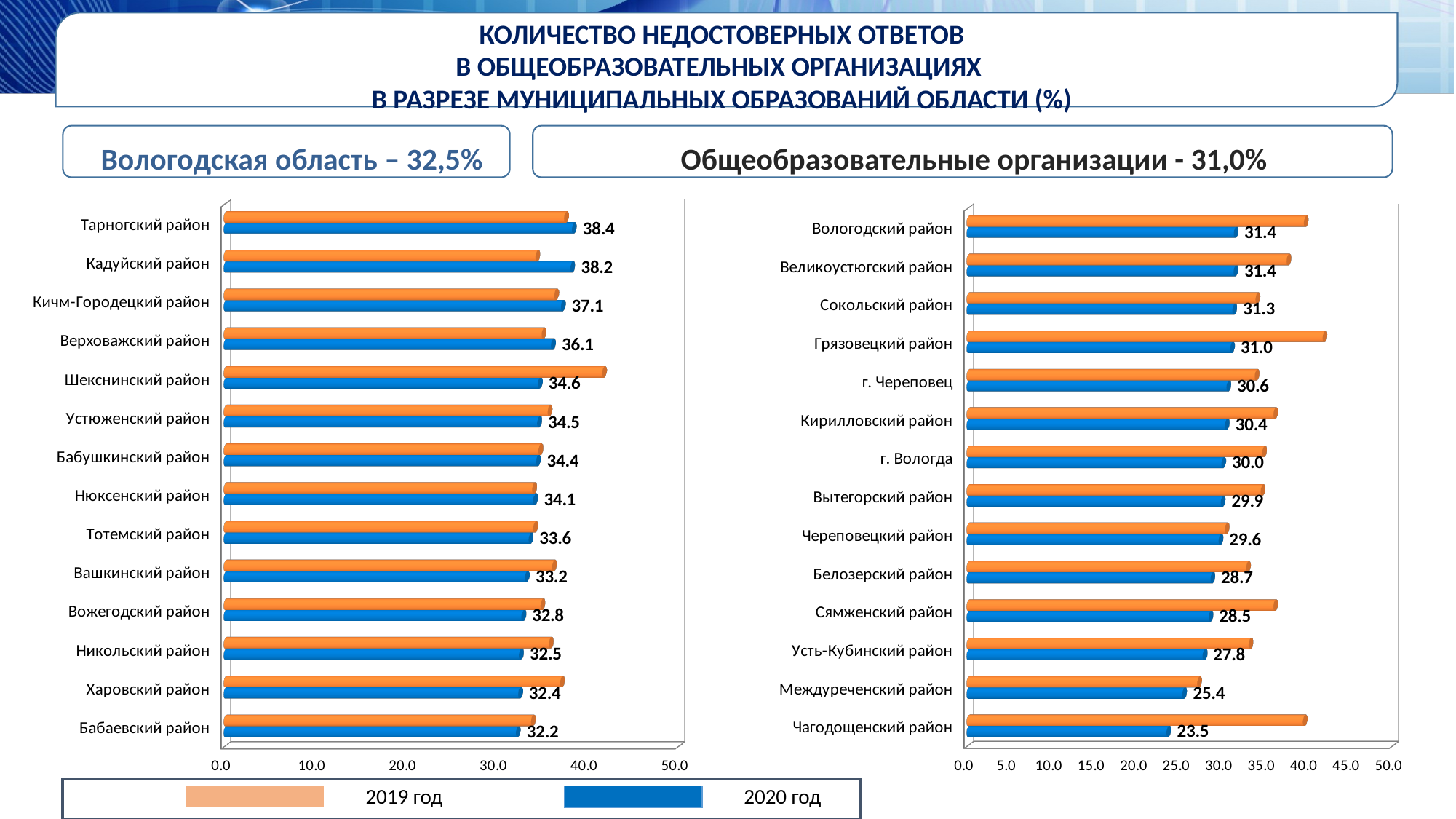
In the left chart, what is the difference between the 2020 values for Тарногский район and Бабаевский район? 6.2 In the left chart, is the 2019 value for Шекснинский район greater or less than 40.0? greater In the right chart, which district has the lowest 2020 value? Чагодощенский район In the right chart, which has the larger 2020 value: г. Череповец or Междуреченский район? г. Череповец In the right chart, what is the 2020 value for Чагодощенский район? 23.5 In the left chart, what is the 2020 value for Вожегодский район? 32.8 In the left chart, what is the 2020 value for Тарногский район? 38.4 In the left chart, which district has the highest 2020 value? Тарногский район How many series does the legend list? 2 What type of chart is the left chart? Bar chart In the right chart, is the 2019 value for Междуреченский район greater or less than 30.0? less How many districts are shown in the right chart? 14